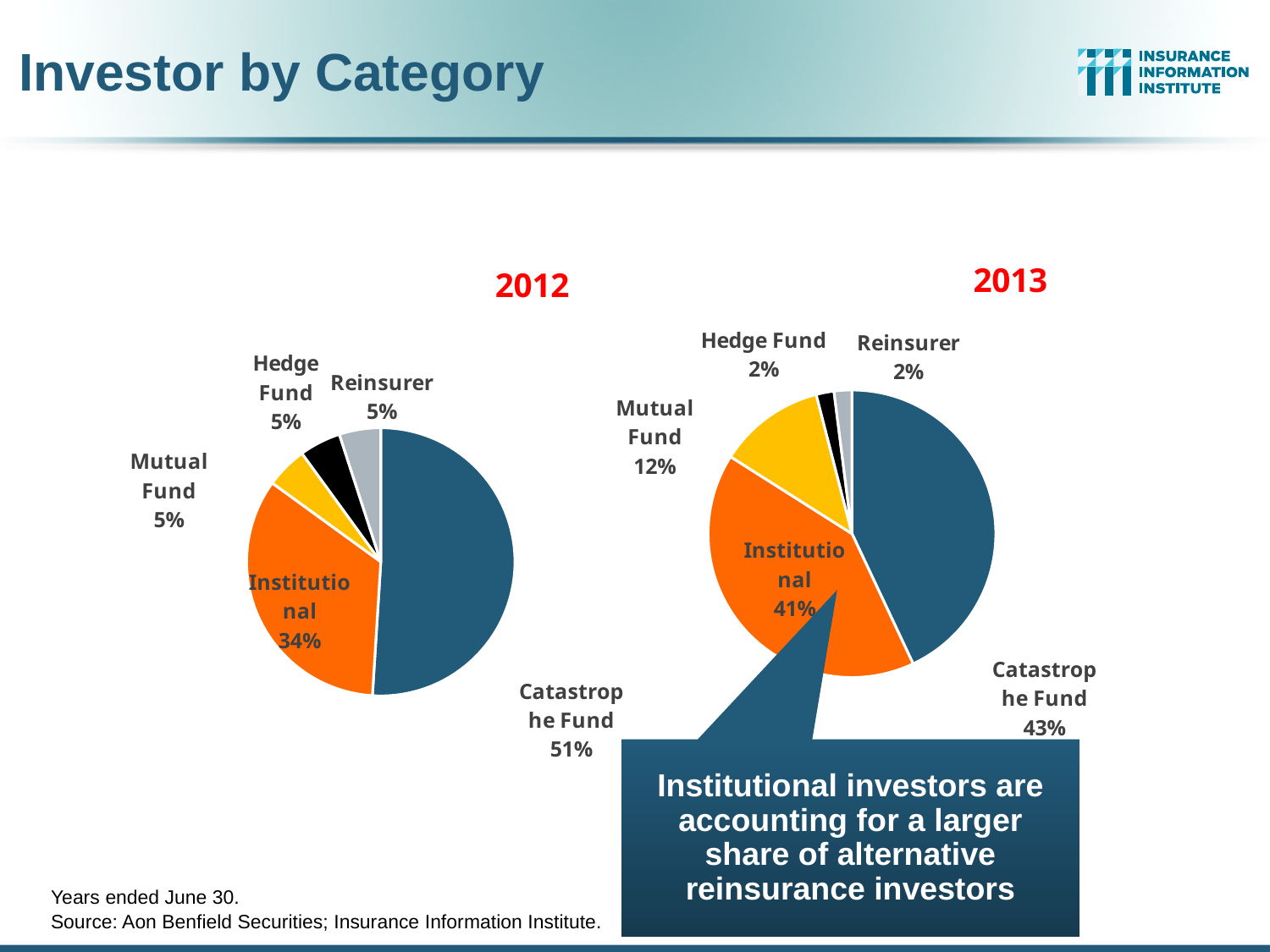
In the 2012 pie chart, what share does Reinsurer have? 5% How many categories are shown in the 2013 pie chart? 5 In the 2013 pie chart, what share does Catastrophe Fund have? 43% What is the title of the slide containing the two pie charts? Investor by Category In the 2012 pie chart, which category has the largest share? Catastrophe Fund How much larger is the Institutional share in 2013 than in 2012? 7 percentage points What type of chart is used to show the 2012 investor breakdown? Pie chart In the 2013 pie chart, what share does Mutual Fund have? 12% In the 2013 pie chart, which category has the largest share? Catastrophe Fund In the 2012 pie chart, what is the difference between the Catastrophe Fund share and the Institutional share? 17 percentage points In the 2013 pie chart, which category has the smallest share, Mutual Fund or Hedge Fund? Hedge Fund